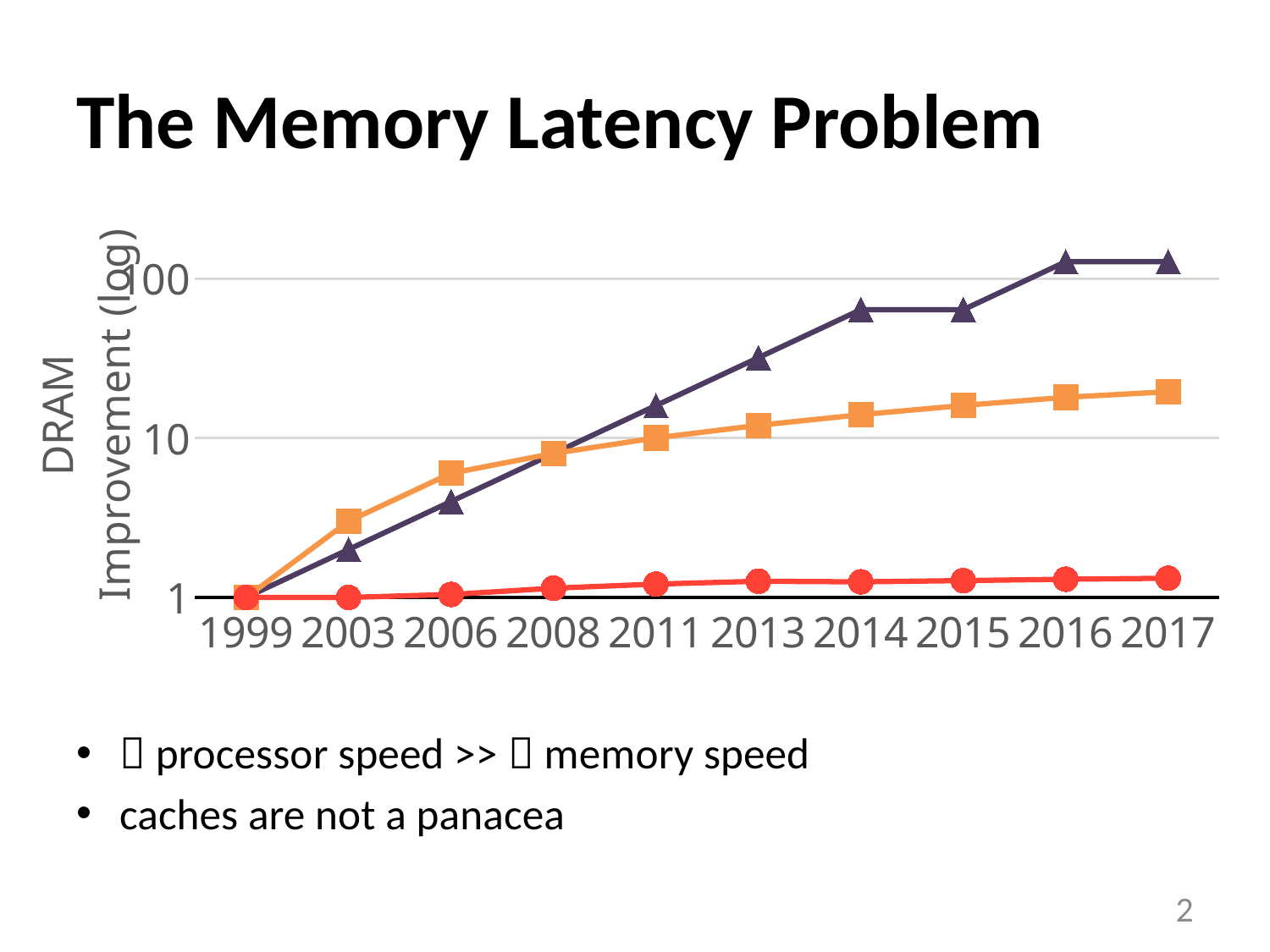
What kind of chart is shown on the slide? line chart What is the label on the vertical axis of the chart? Improvement (log) In 2003, which is larger: the orange square line or the purple triangle line? the orange square line What is the value of the purple triangle line in 1999? 1 Is the value of the red circle line in 2017 greater or less than 10? less Does the purple triangle line rise or fall from 1999 to 2017? rise Is the value of the purple triangle line in 2017 greater or less than 100? greater How many lines are plotted on the chart? 3 Is the value of the orange square line in 2017 greater or less than 10? greater How many years are marked along the x axis of the chart? 10 Which line has the highest value in 2017? the purple triangle line Which line has the lowest value in 2017? the red circle line